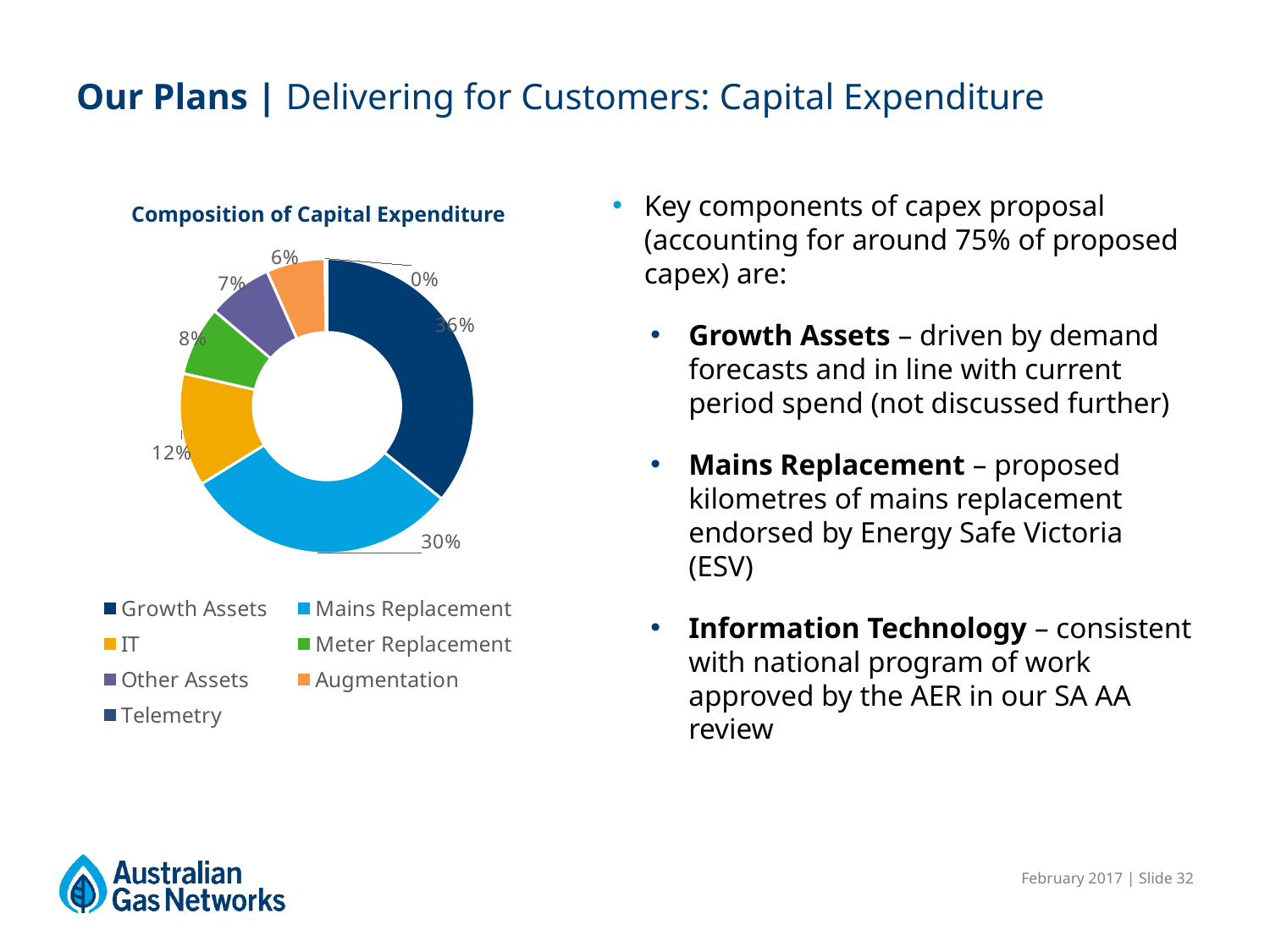
Which category has the smallest share of capital expenditure? Telemetry What share of capital expenditure is IT? 12% Which category has the largest share of capital expenditure? Growth Assets What kind of chart is shown on the slide? Doughnut (pie) chart What share of capital expenditure is Augmentation? 6% What is the difference in share between Growth Assets and Mains Replacement? 6% How many categories does the legend list? 7 What share of capital expenditure is Growth Assets? 36% What is the title of the chart? Composition of Capital Expenditure Which has a larger share, IT or Other Assets? IT